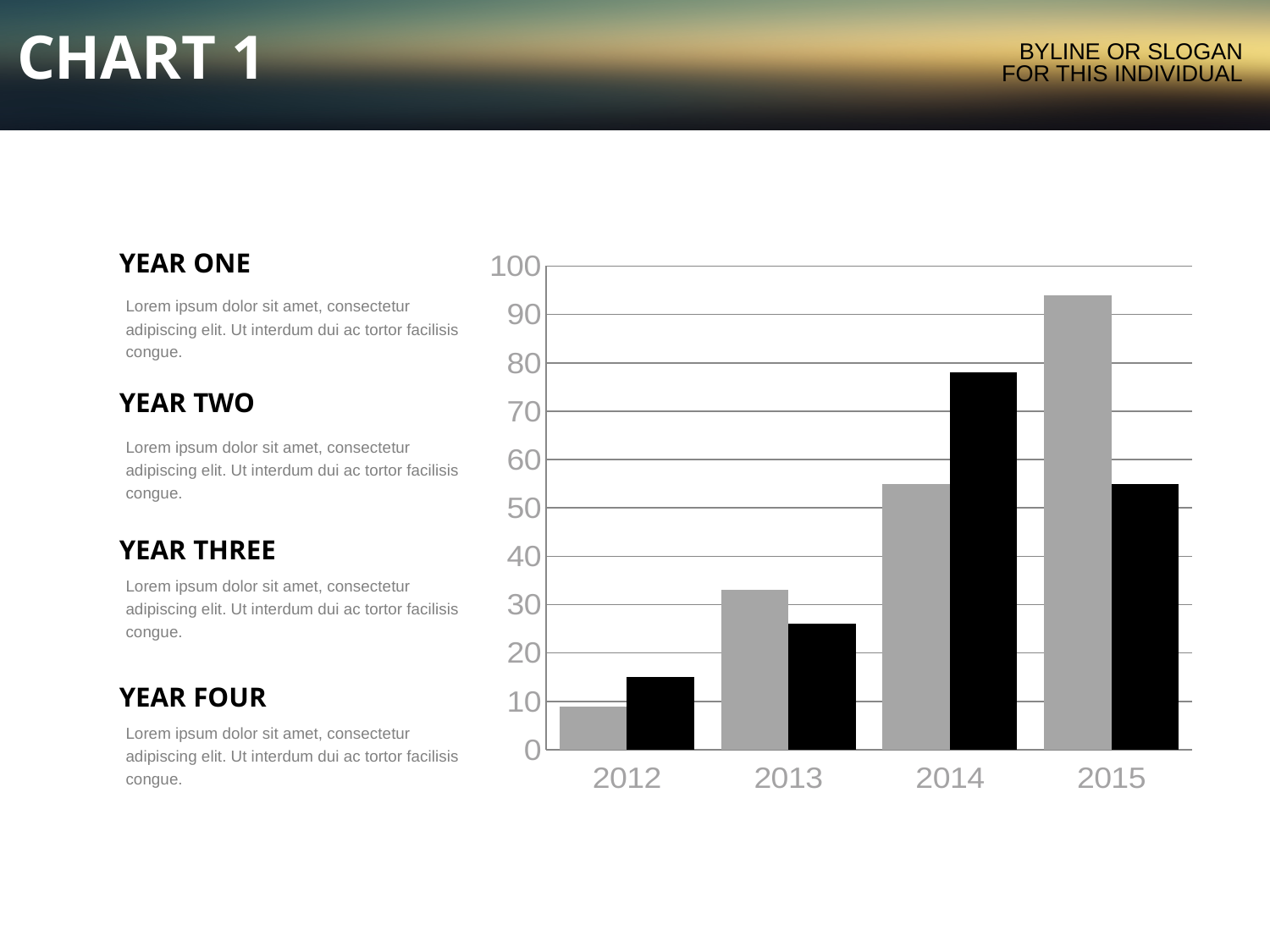
Which year has the shortest gray bar? 2012 Which year has the tallest gray bar? 2015 Is the gray bar for 2015 greater or less than 90? greater Which year has the tallest black bar? 2014 Which year has the shortest black bar? 2012 How many categories are shown on the x axis of the chart? 4 What kind of chart is shown on the slide? bar chart Is the black bar for 2013 greater or less than 30? less In 2014, which bar is taller, the gray bar or the black bar? the black bar Is the black bar for 2014 greater or less than 70? greater Do the gray bars rise or fall from 2012 to 2015? rise